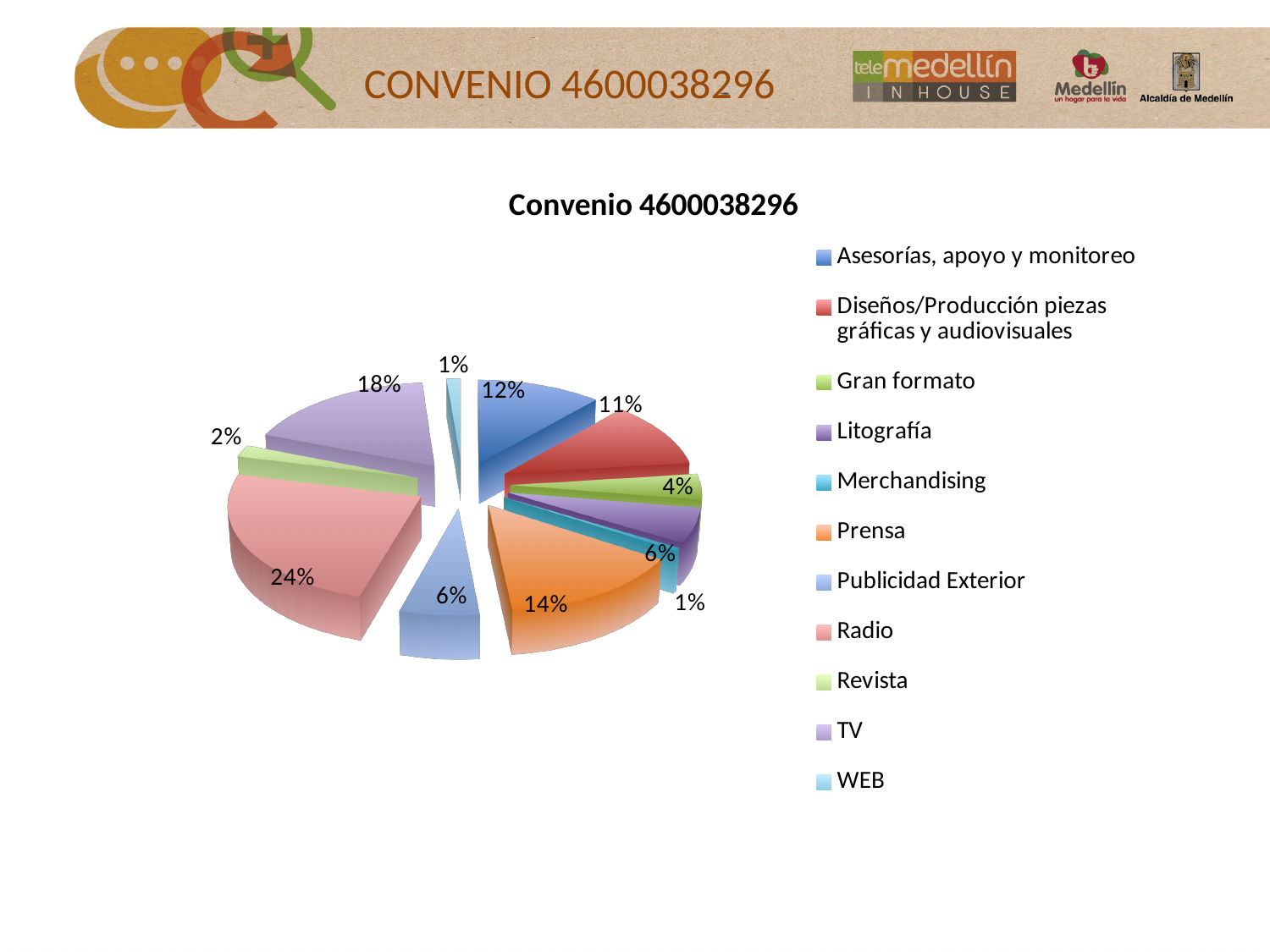
How many categories does the legend list? 11 What is the difference between the Radio share and the TV share? 6% Which is larger, the share for TV or the share for Prensa? TV What percentage is shown for Asesorías, apoyo y monitoreo? 12% What percentage is shown for TV? 18% What percentage is shown for Gran formato? 4% What type of chart is shown on the slide? pie chart What percentage is shown for Revista? 2% What share of the pie does Radio represent? 24% What percentage is shown for Prensa? 14% Which category has the largest slice of the pie? Radio What is the title of the chart? Convenio 4600038296